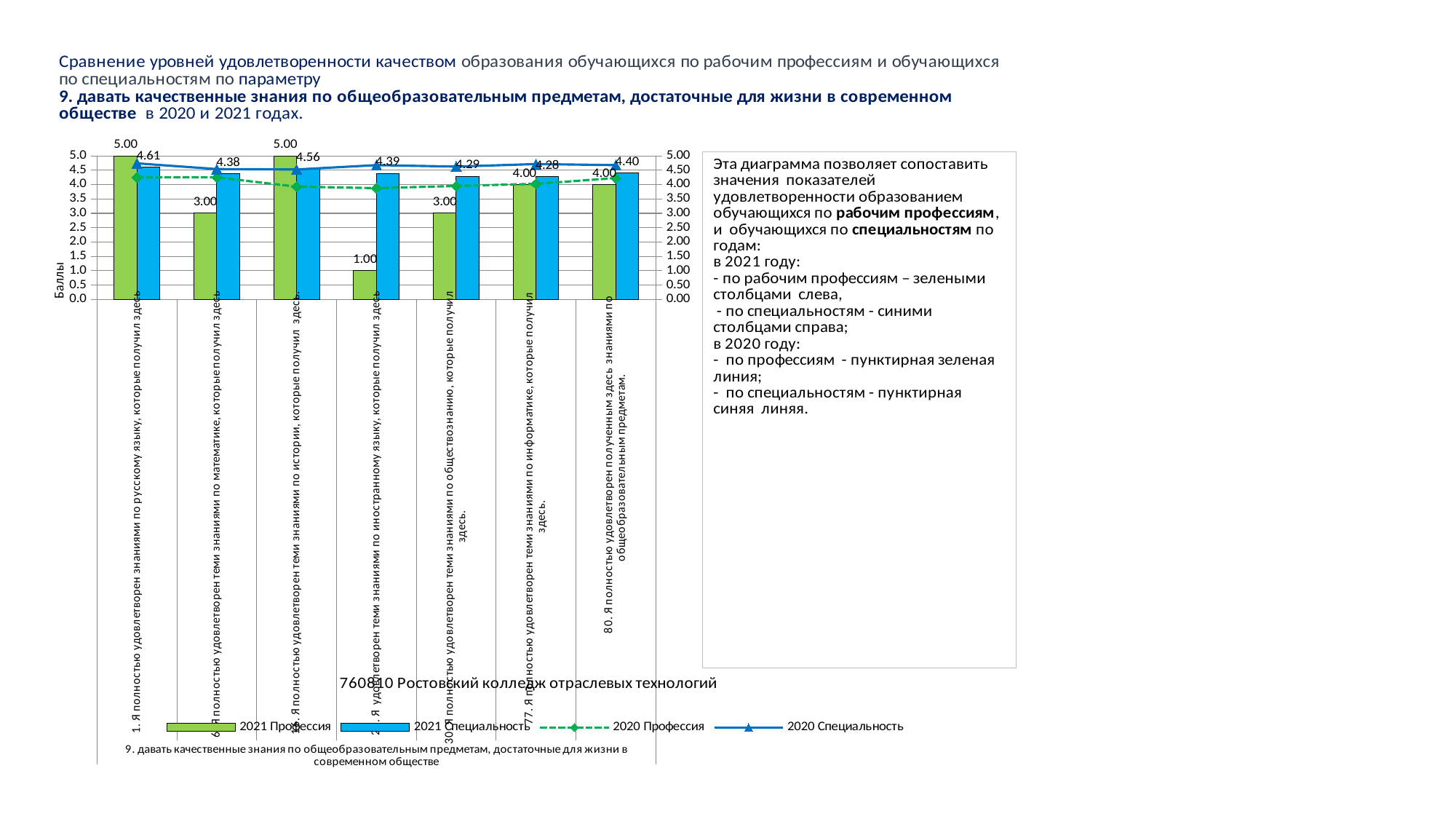
How many series does the legend list? 4 What is the value of the 2021 Профессия bar for the category about математике (6)? 3.00 What colour are the 2021 Профессия bars? Green What is the difference between the 2021 Профессия values for русскому языку (1) and иностранному языку (23)? 4.00 Which category has the lowest 2021 Профессия bar? 25. Я удовлетворен теми знаниями по иностранному языку, которые получил здесь How many categories are plotted along the x axis? 7 What is the value of the 2021 Профессия bar for the category about иностранному языку (23)? 1.00 What kind of chart is shown on the slide? Bar chart (with line series) What is the value of the 2021 Профессия bar for the category about информатике (77)? 4.00 Is the 2021 Специальность bar for the category about русскому языку (1) greater or less than 4.0? greater For the category about иностранному языку (23), which is larger: the 2021 Профессия bar or the 2021 Специальность bar? 2021 Специальность What is the title of the vertical axis? Баллы